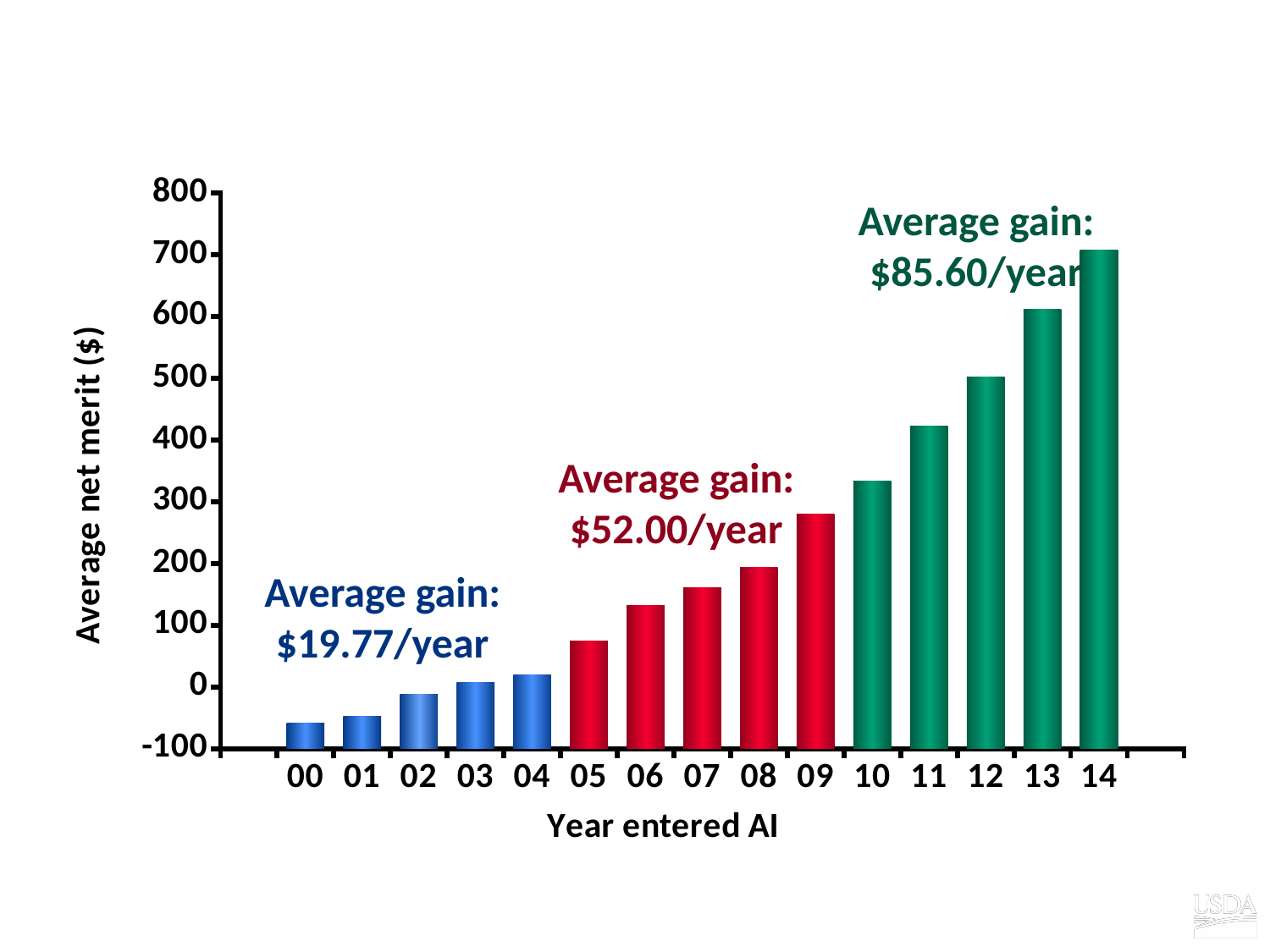
Which year entered AI has the highest average net merit? 14 Which year has a higher average net merit, 06 or 10? 10 What is the label of the y axis? Average net merit ($) What average gain per year is stated for the green bars (years 10 to 14)? $85.60/year Is the average net merit for year 11 greater or less than 400? greater How many years (bars) are plotted on the x axis? 15 What kind of chart is shown on the slide? bar chart Is the average net merit for year 00 greater or less than 0? less Do the average net merit values rise or fall as the year entered AI increases from 00 to 14? rise Which year entered AI has the lowest average net merit? 00 Is the average net merit for year 09 greater or less than 300? less